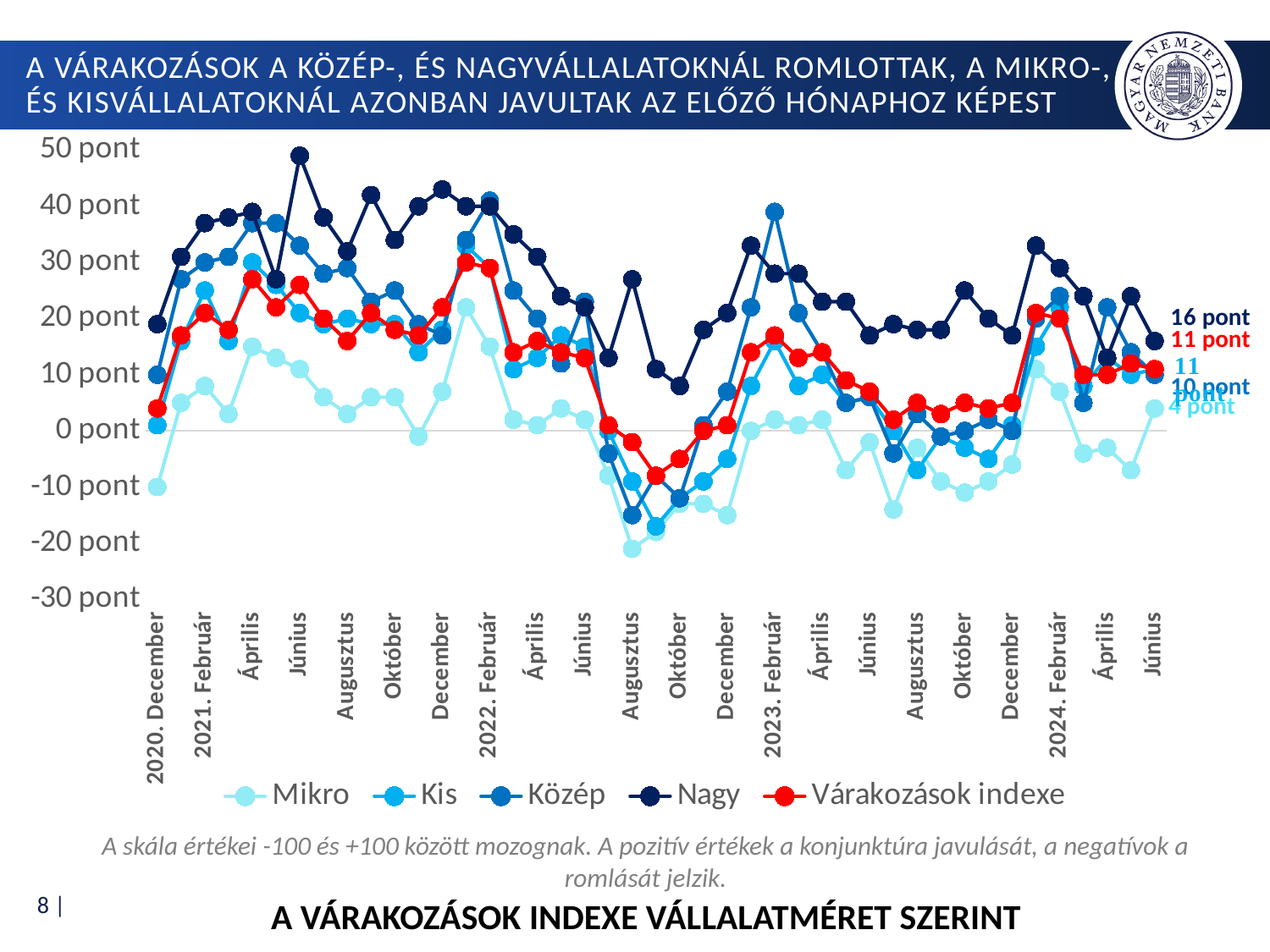
At the last point of the chart (2024 June), which is larger: the Nagy value or the Várakozások indexe value? Nagy What is the difference between the Nagy and Mikro values at the last point of the chart (2024 June)? 12 pont What is the value of the Várakozások indexe series at the end of the chart (2024 June)? 11 pont What kind of chart is shown on the slide? line chart Which series is listed first in the legend? Mikro What is the value of the Mikro series at the end of the chart (2024 June)? 4 pont Which series has the highest value at the last point of the chart (2024 June)? Nagy What is the value of the Nagy series at the end of the chart (2024 June)? 16 pont How many series does the legend list? 5 Is the value of the Nagy series in 2021 Június greater or less than 40 pont? greater Which series has the lowest value at the last point of the chart (2024 June)? Mikro Is the value of the Mikro series in 2022 Augusztus greater or less than -10 pont? less